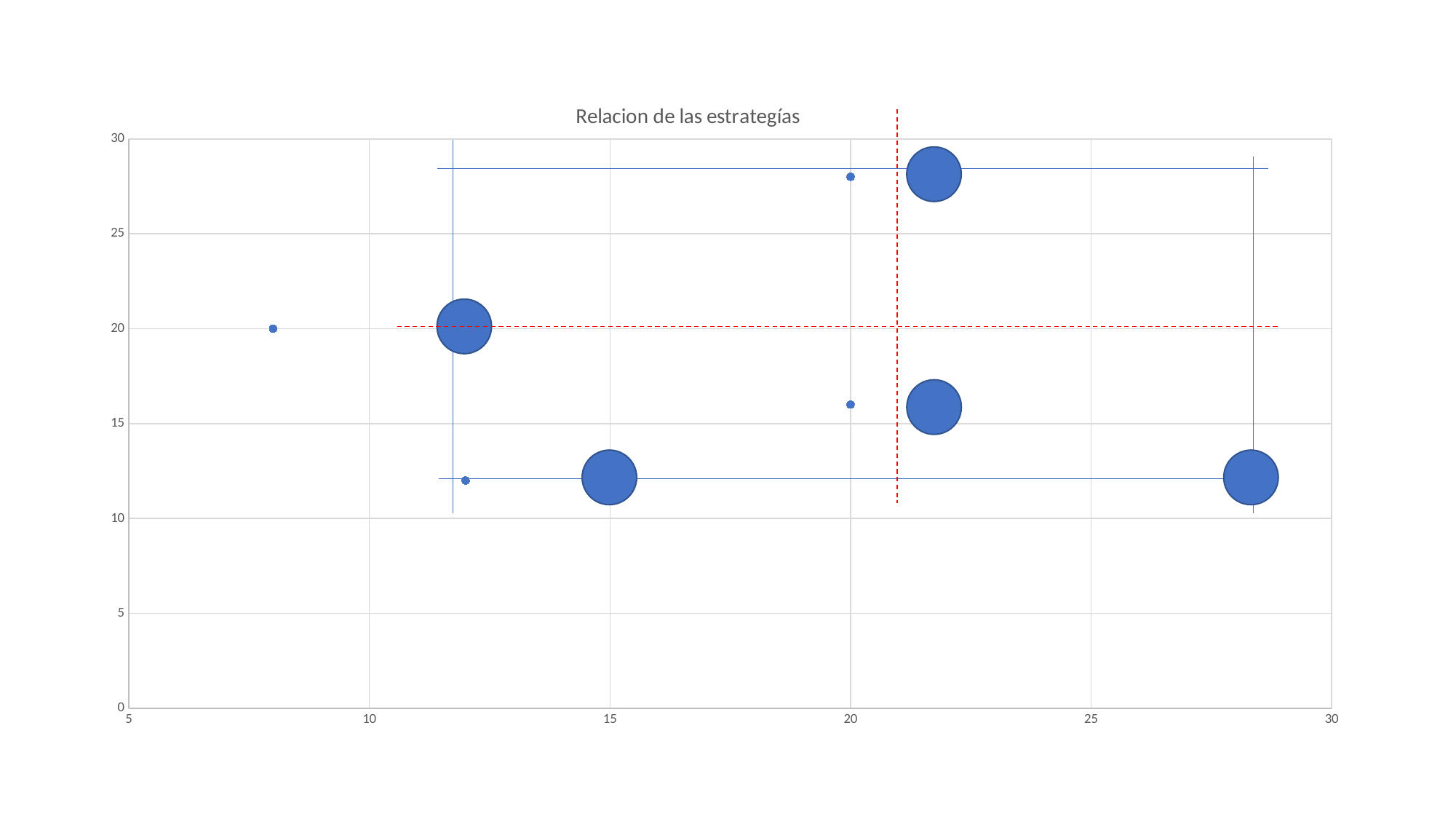
How many data points (bubbles and dots together) are plotted on the chart? 9 What kind of chart is shown on the slide? bubble chart Is the y value of the large bubble near x = 12 greater or less than 15? greater What is the title of the chart? Relacion de las estrategías What is the highest value shown on the y axis? 30 Is the y value of the large bubble near x = 15 greater or less than 15? less Is the x value of the leftmost point greater or less than 10? less How many large bubbles are plotted on the chart? 5 How many small dots (points) are plotted on the chart, not counting the large bubbles? 4